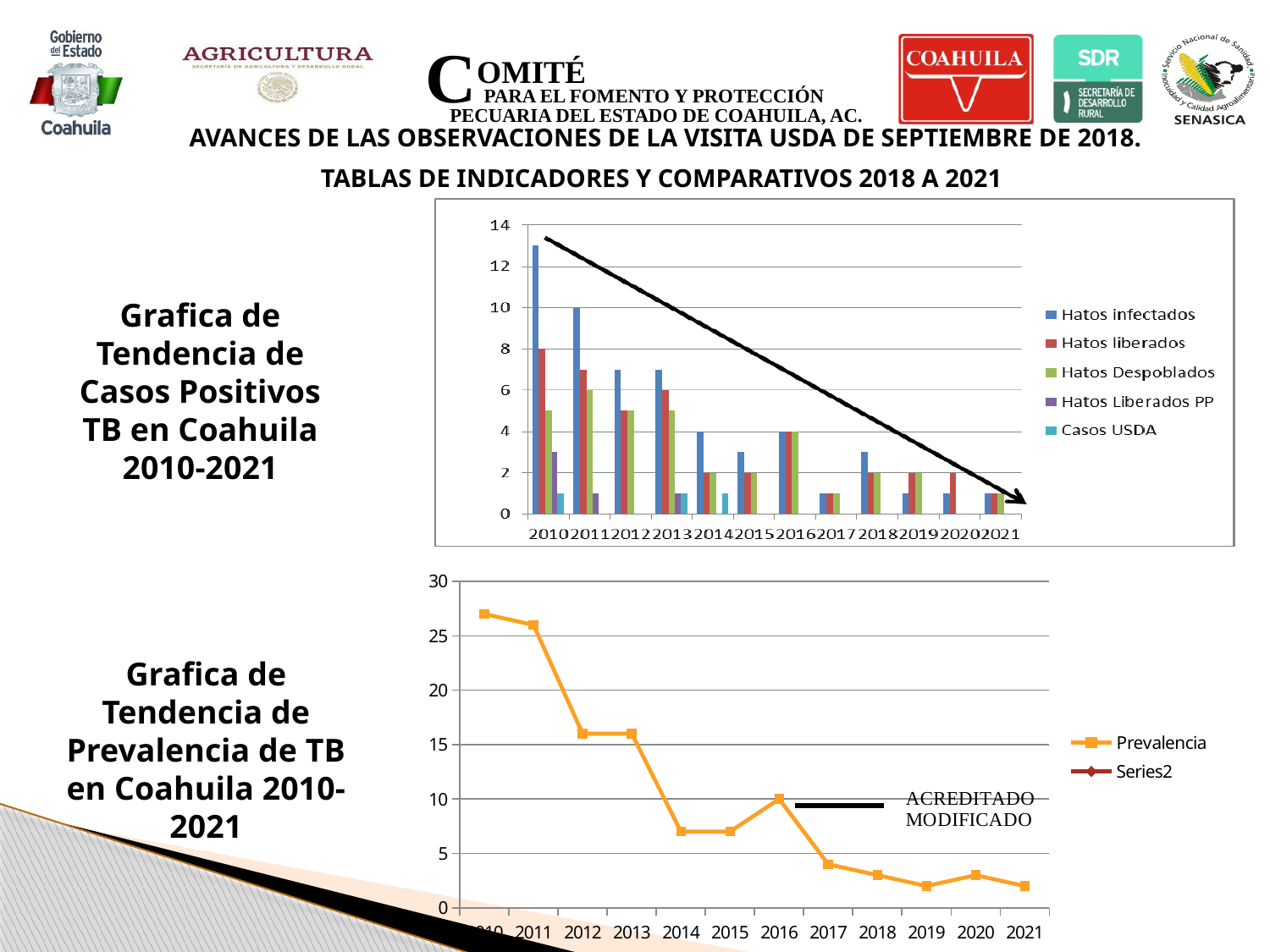
In the bottom line chart, is the Prevalencia value for 2019 greater or less than 5? less How many series does the legend of the top bar chart list? 5 In the top bar chart, which is larger in 2011: Hatos infectados or Hatos liberados? Hatos infectados How many years are shown on the x axis of the top bar chart? 12 What kind of chart is the bottom chart (Grafica de Tendencia de Prevalencia de TB en Coahuila 2010-2021)? line chart In the bottom line chart, does the Prevalencia value generally rise or fall from 2010 to 2021? fall In the top bar chart, which year has the highest value for Hatos infectados? 2010 In the top bar chart, is the value for Hatos infectados in 2010 greater or less than 12? greater In the bottom line chart, is the Prevalencia value for 2010 greater or less than 25? greater What kind of chart is the top chart (Grafica de Tendencia de Casos Positivos TB en Coahuila 2010-2021)? bar chart In the bottom line chart, what is the Prevalencia value for 2016? 10 In the top bar chart, what is the value for Hatos infectados in 2011? 10